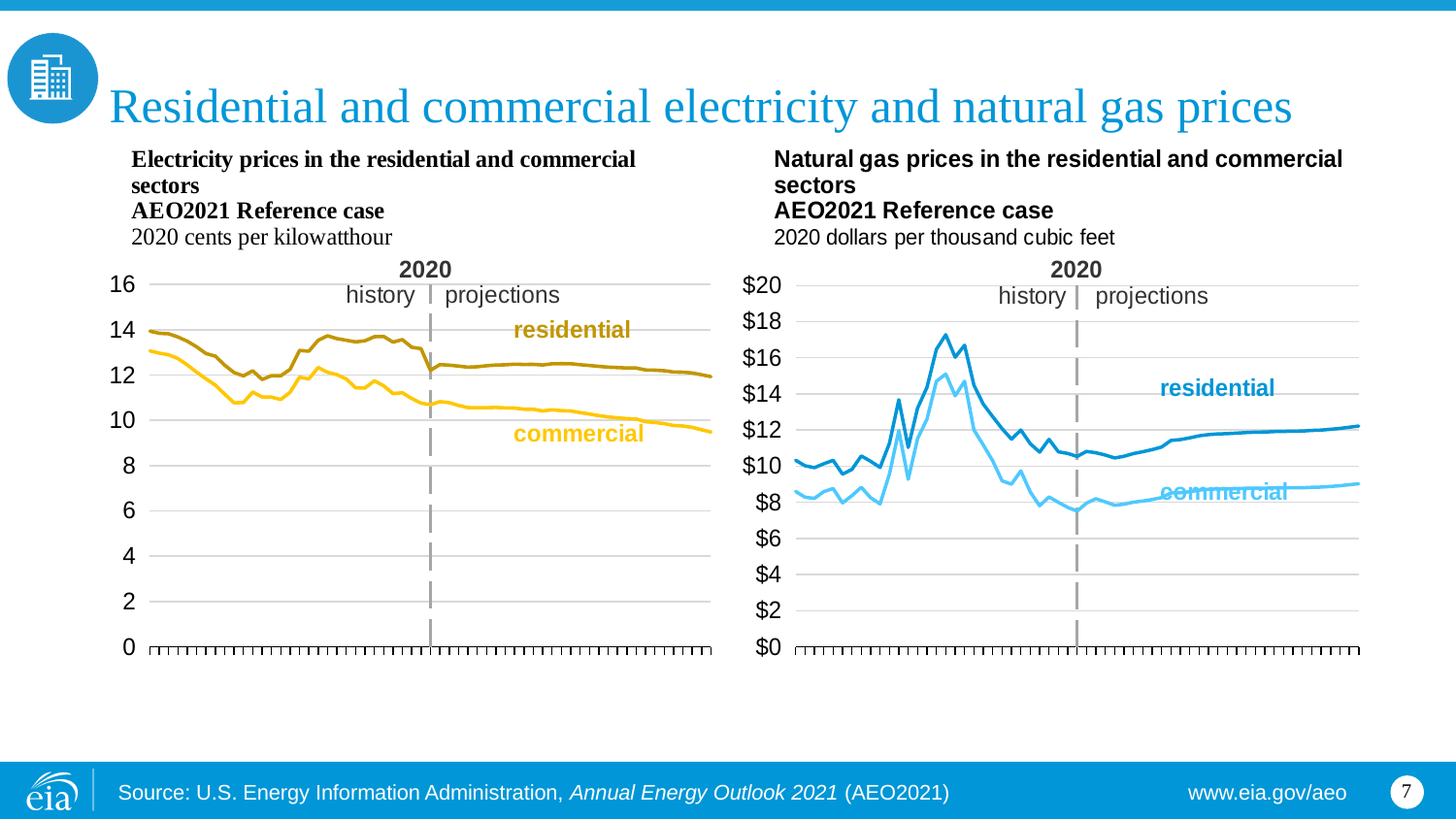
How many series are plotted on the 'Electricity prices in the residential and commercial sectors' chart? 2 On the 'Natural gas prices in the residential and commercial sectors' chart, is the commercial value at the end of the projection period greater or less than $10? less What unit is used on the 'Natural gas prices in the residential and commercial sectors' chart? 2020 dollars per thousand cubic feet On the 'Electricity prices in the residential and commercial sectors' chart, is the commercial value at the end of the projection period greater or less than 12? less On the 'Natural gas prices in the residential and commercial sectors' chart, is the peak residential value greater or less than $16? greater On the 'Natural gas prices in the residential and commercial sectors' chart, does the residential series rise or fall over the projection period? rise What kind of chart is the 'Electricity prices in the residential and commercial sectors' chart? line chart What kind of chart is the 'Natural gas prices in the residential and commercial sectors' chart? line chart How many series are plotted on the 'Natural gas prices in the residential and commercial sectors' chart? 2 On the 'Natural gas prices in the residential and commercial sectors' chart, which series is higher at the end of the projection period, residential or commercial? residential On the 'Electricity prices in the residential and commercial sectors' chart, which series is higher at the end of the projection period, residential or commercial? residential